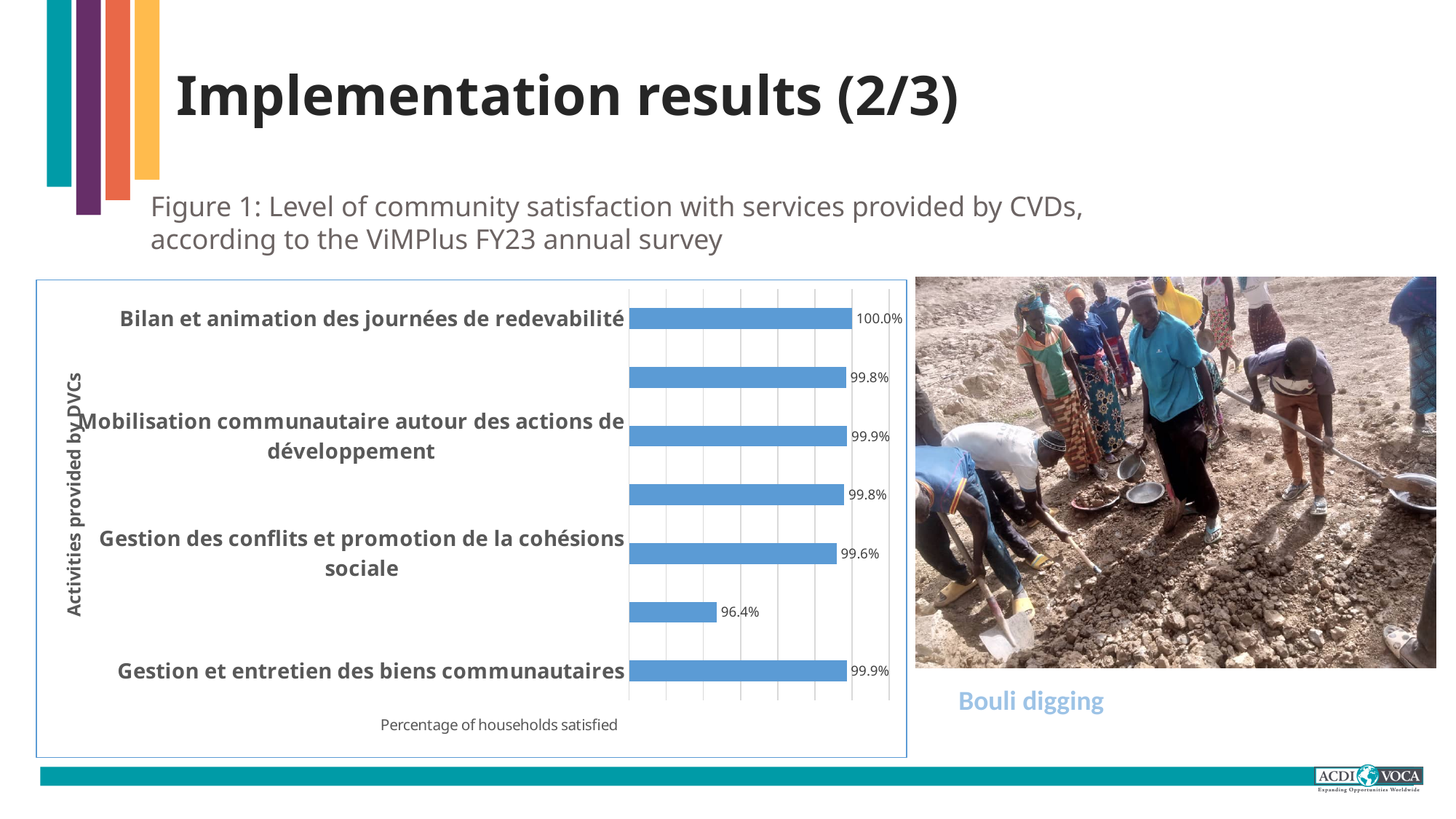
What is the percentage of households satisfied for 'Bilan et animation des journées de redevabilité'? 100.0% Which labelled activity has the highest percentage of households satisfied? Bilan et animation des journées de redevabilité Which has a higher satisfaction value: 'Gestion et entretien des biens communautaires' or 'Gestion des conflits et promotion de la cohésions sociale'? Gestion et entretien des biens communautaires What is the title of the vertical axis of the chart? Activities provided by DVCs What is the lowest satisfaction value shown on the chart? 96.4% What is the difference between the satisfaction values for 'Bilan et animation des journées de redevabilité' and 'Gestion des conflits et promotion de la cohésions sociale'? 0.4 percentage points What is the percentage of households satisfied for 'Gestion des conflits et promotion de la cohésions sociale'? 99.6% What kind of chart is shown on the slide? Bar chart What is the title of the horizontal axis of the chart? Percentage of households satisfied What is the percentage of households satisfied for 'Gestion et entretien des biens communautaires'? 99.9% How many bars are plotted on the chart? 7 What is the percentage of households satisfied for 'Mobilisation communautaire autour des actions de développement'? 99.9%